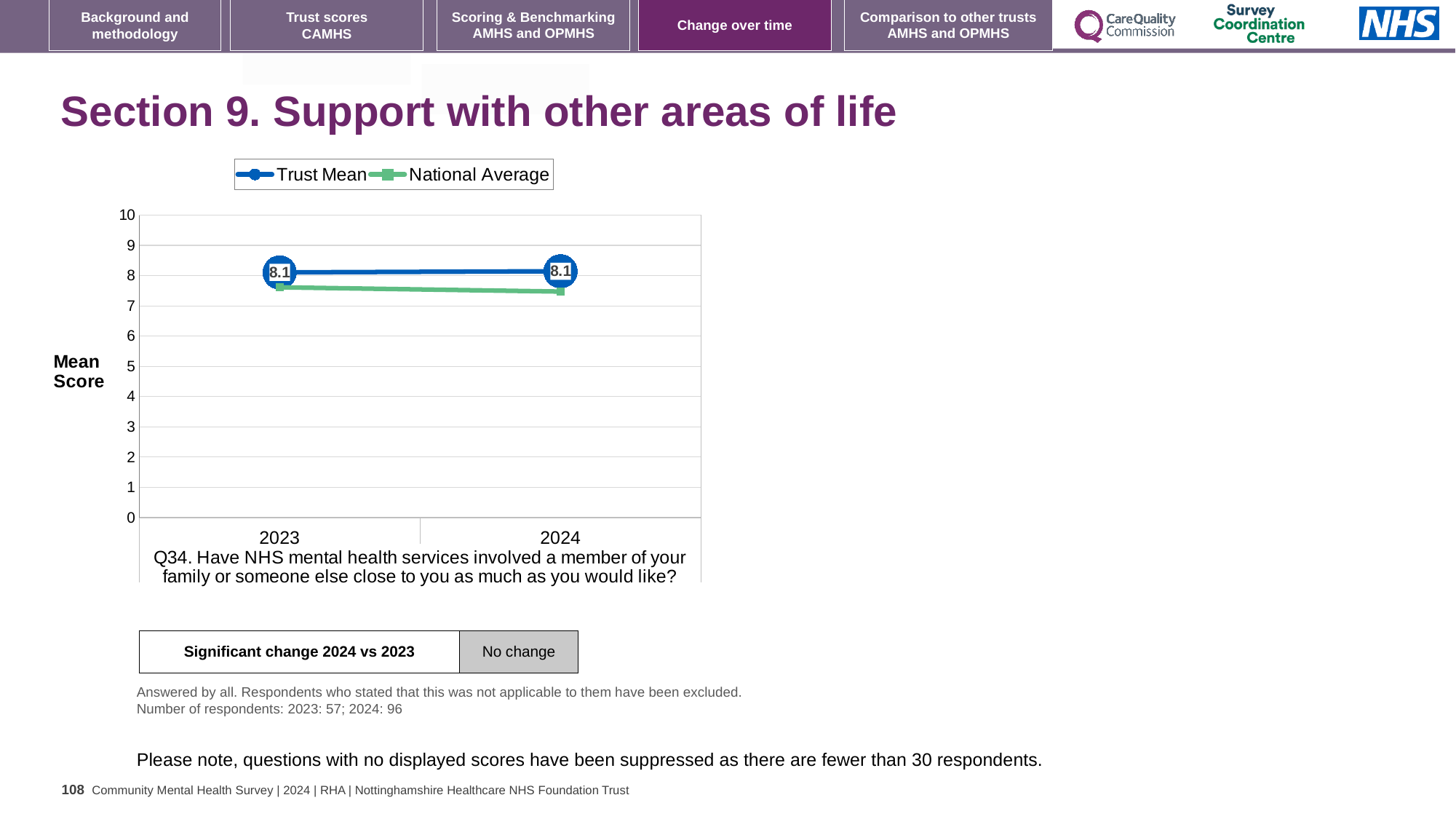
How many series does the legend list? 2 What is the Trust Mean score for 2023? 8.1 In 2024, which is higher: the Trust Mean or the National Average? Trust Mean What is the difference between the Trust Mean score in 2024 and in 2023? 0 What is the label of the y axis? Mean Score Does the Trust Mean rise, fall or stay the same from 2023 to 2024? stays the same In 2023, which is higher: the Trust Mean or the National Average? Trust Mean How many years are shown on the x axis? 2 What is the Trust Mean score for 2024? 8.1 What kind of chart is shown on the slide? line chart Is the National Average value for 2023 greater or less than 8? less Is the National Average value for 2024 greater or less than 7? greater